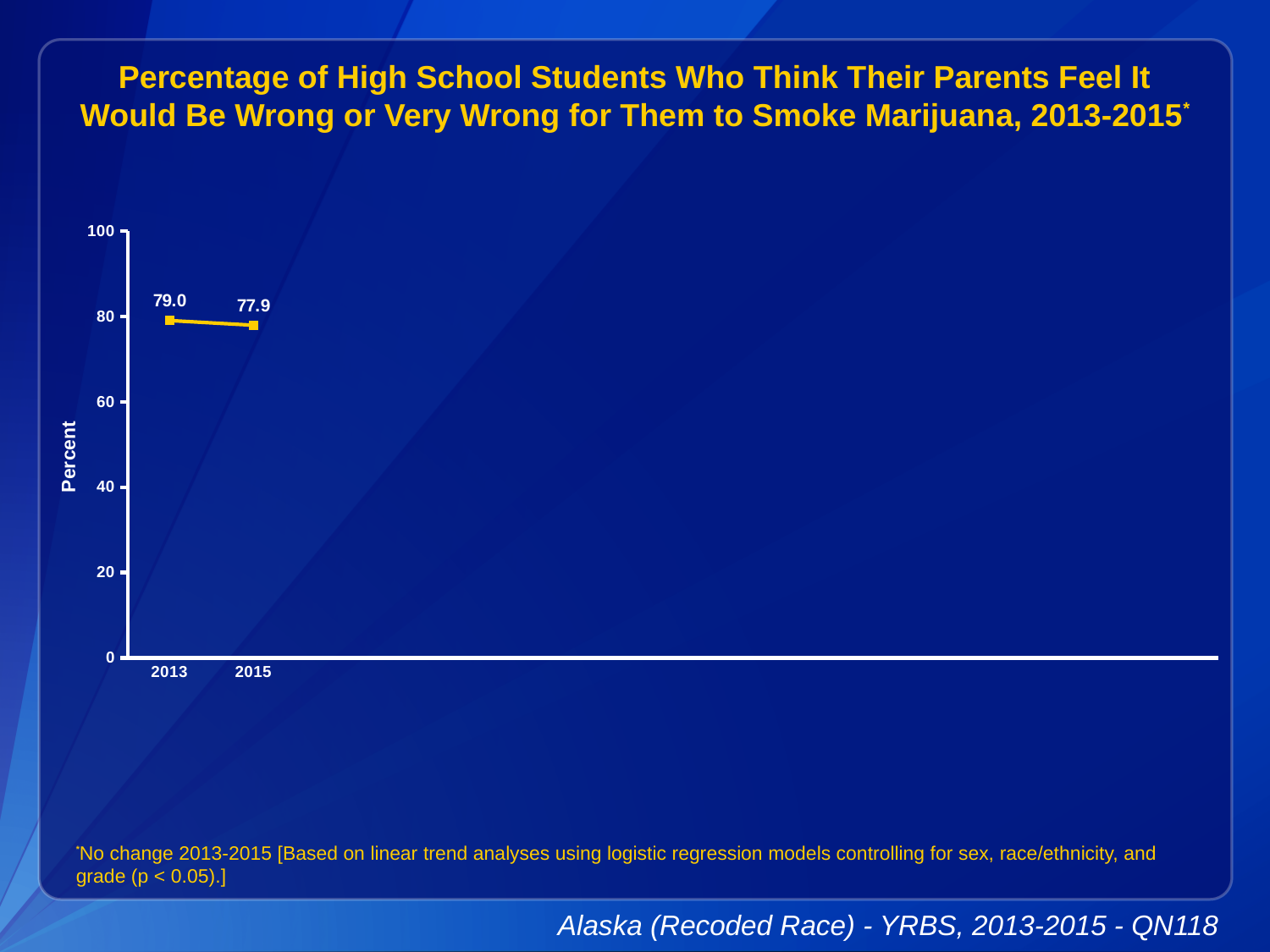
Which year has the lowest value? 2015 Which is larger, the value for 2013 or the value for 2015? 2013 What is the difference between the 2013 and 2015 values? 1.1 Do the values rise or fall from 2013 to 2015? fall What is the value for 2013? 79.0 What is the value for 2015? 77.9 What is the maximum value shown on the y axis? 100 What is the label on the y axis? Percent What kind of chart is shown on the slide? line chart Is the value for 2015 greater or less than 80? less How many data points are plotted on the chart? 2 Which year has the highest value? 2013